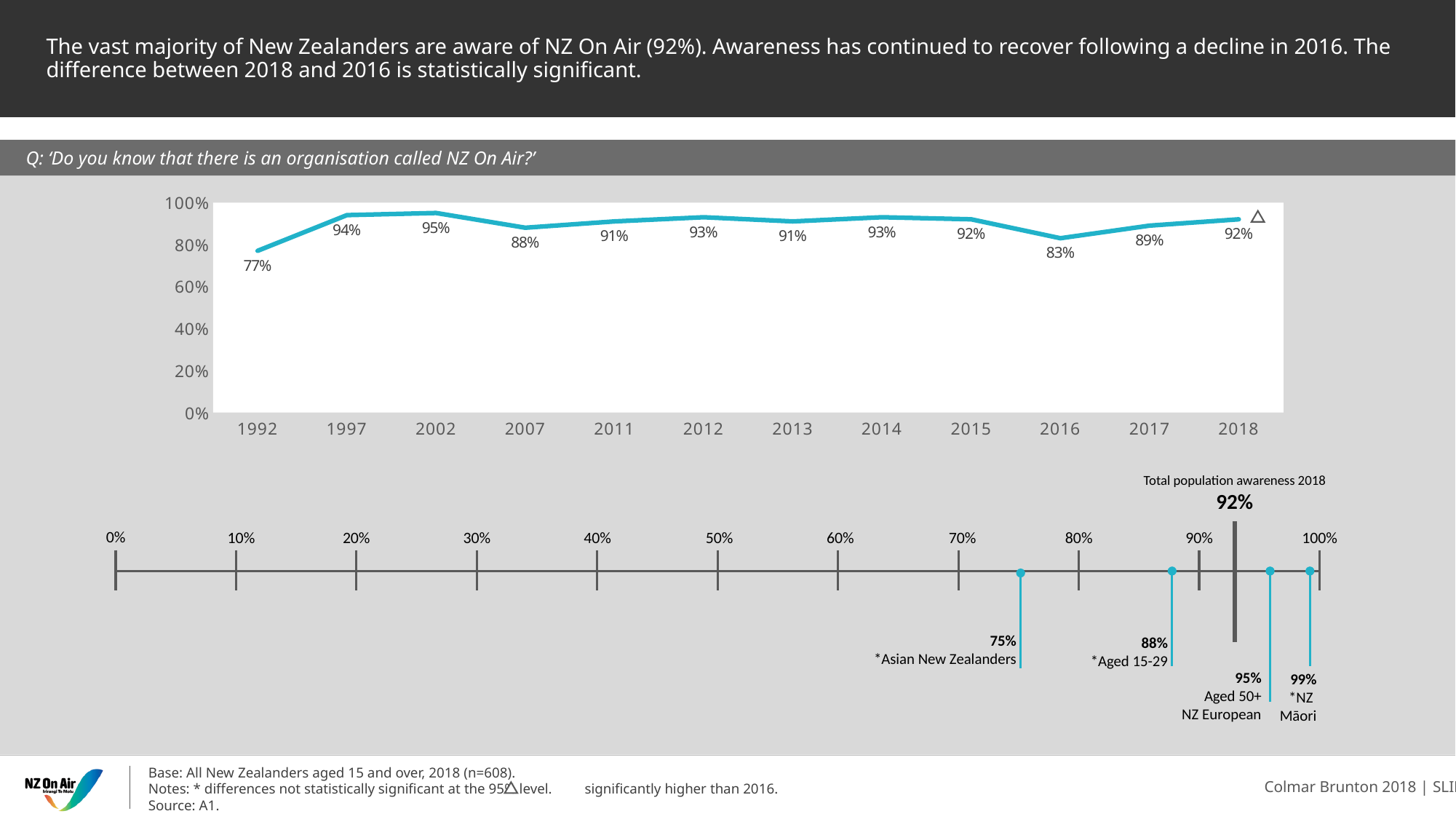
In the line chart, did awareness rise or fall from 2016 to 2018? Rise In the line chart, which year has the higher value, 2007 or 2017? 2017 How many years are plotted on the line chart? 12 What type of chart is the top chart showing awareness from 1992 to 2018? Line chart In the line chart, what is the difference between the 2018 value and the 2016 value? 9 percentage points In the bottom scale chart, what is the awareness value for Asian New Zealanders? 75% In the bottom scale chart, what is the difference between the NZ Māori value and the Aged 15-29 value? 11 percentage points In the line chart, what was awareness of NZ On Air in 1992? 77% In the line chart, what was awareness of NZ On Air in 2016? 83% In the bottom scale chart, which group has the highest awareness? NZ Māori In the line chart, which year has the highest awareness value? 2002 In the line chart, which year has the lowest awareness value? 1992